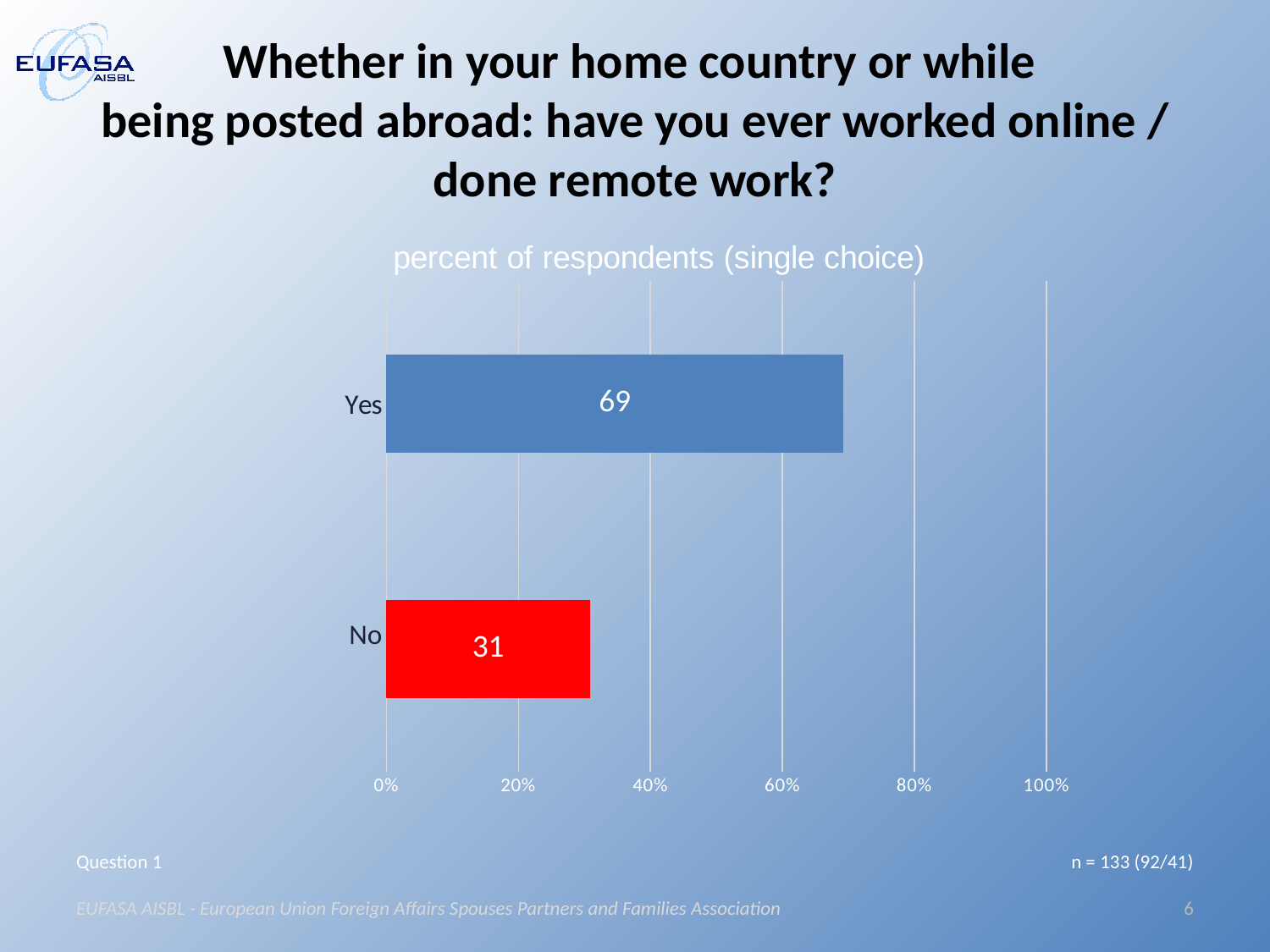
Which category has the lowest value? No What is the value for No? 31 Which category has the highest value? Yes Is the value for No greater or less than 40%? less What is the title of the chart? percent of respondents (single choice) How many categories are shown in the chart? 2 What kind of chart is shown on the slide? bar chart What is the difference between the values for Yes and No? 38 Which is larger, the value for Yes or the value for No? Yes What colour is the bar for No? red What is the value for Yes? 69 Is the value for Yes greater or less than 60%? greater